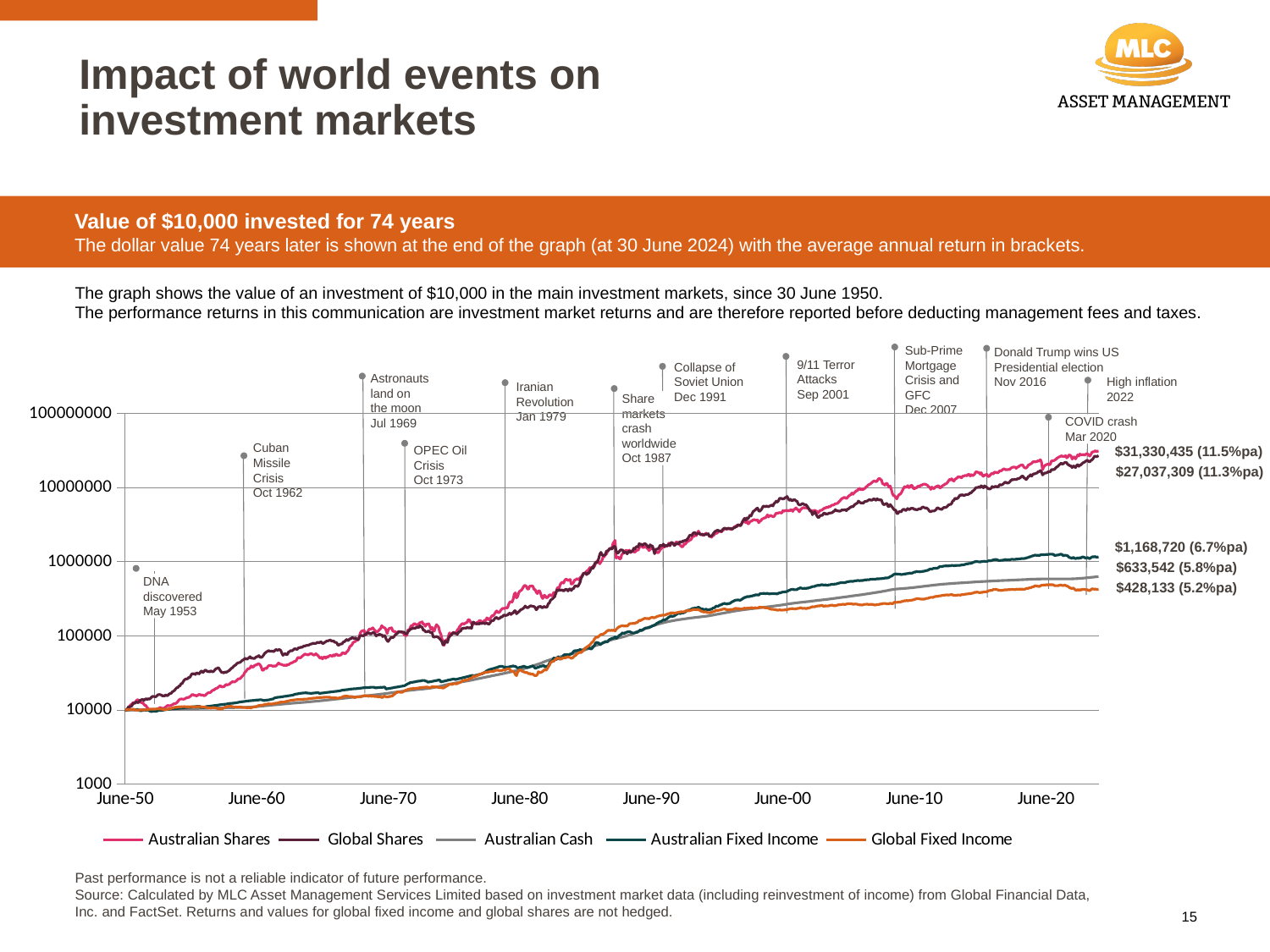
Which series has the lowest value at the end of the graph? Global Fixed Income What is the end value shown for Global Fixed Income at 30 June 2024? $428,133 (5.2%pa) Do the values for Global Shares generally rise or fall from June-50 to June-20? Rise How many series does the legend list? 5 What is the end value shown for Australian Fixed Income at 30 June 2024? $1,168,720 (6.7%pa) Which series has the highest value at the end of the graph? Australian Shares What is the end value shown for Global Shares at 30 June 2024? $27,037,309 (11.3%pa) What is the title of the chart? Value of $10,000 invested for 74 years What is the average annual return shown for Australian Cash? 5.8%pa What kind of chart is shown on the slide? Line chart Which has a higher end value, Australian Cash or Global Fixed Income? Australian Cash What is the end value shown for Australian Shares at 30 June 2024? $31,330,435 (11.5%pa)